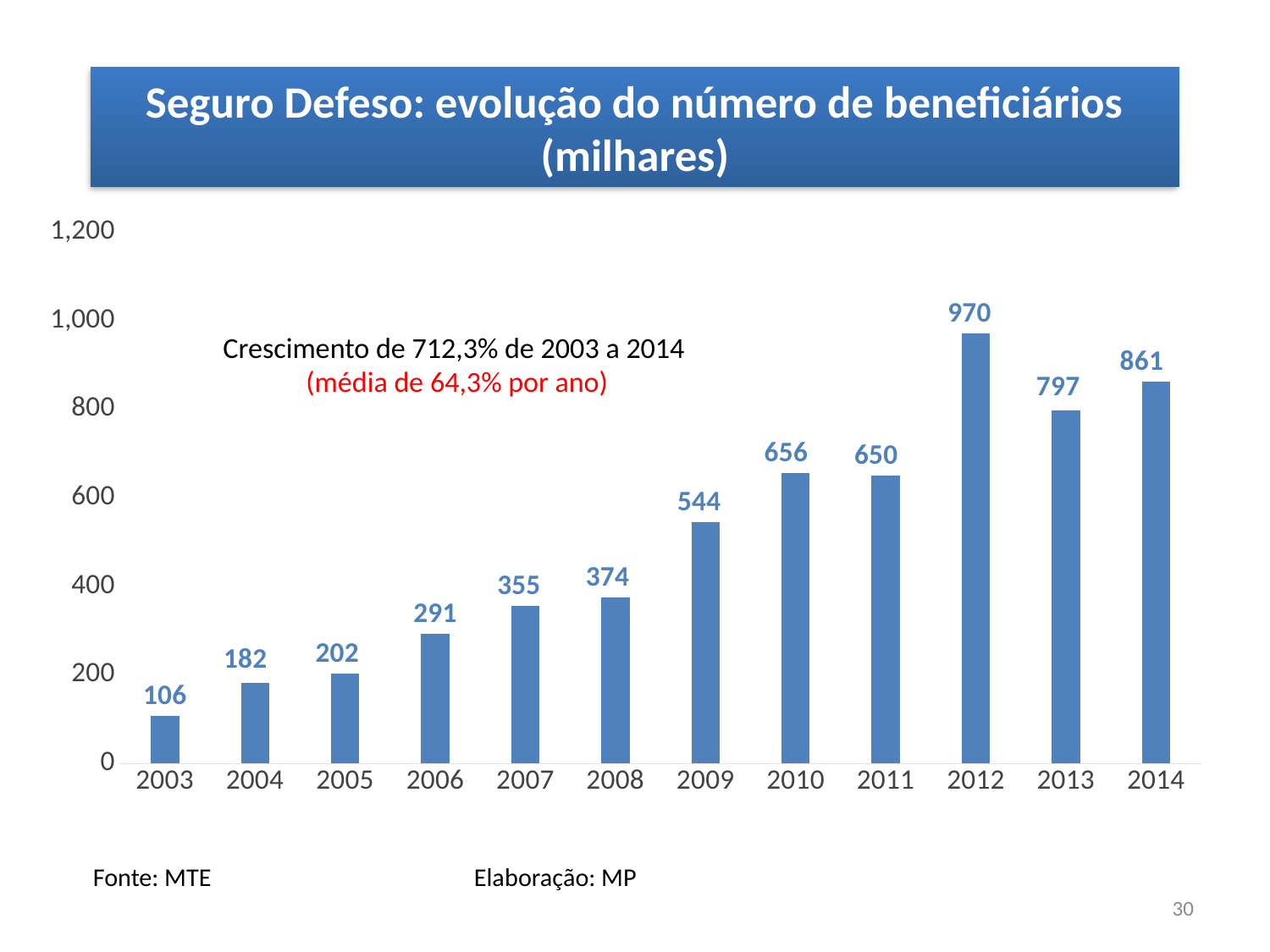
Which year has the lowest value? 2003 What is the difference between the values for 2012 and 2013? 173 What is the value for 2003? 106 Is the value for 2008 greater or less than 400? less What is the title of the chart? Seguro Defeso: evolução do número de beneficiários (milhares) How many years are shown on the x axis? 12 What is the difference between the values for 2014 and 2003? 755 Which year has the highest value? 2012 What kind of chart is shown on the slide? bar chart Which is larger, the value for 2010 or the value for 2011? 2010 What is the value for 2012? 970 What is the value for 2009? 544